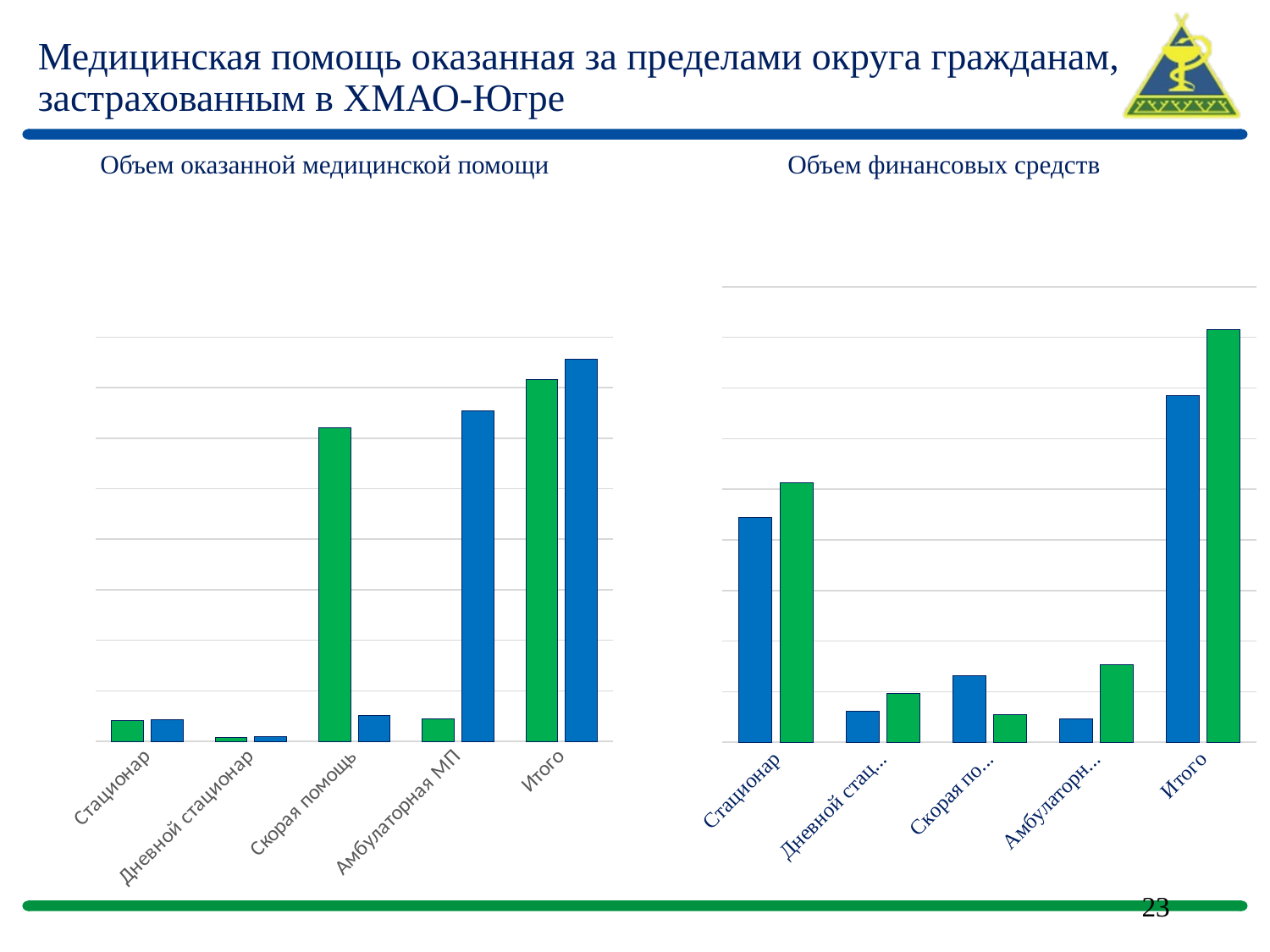
How many categories are shown on the x axis of the right chart "Объем финансовых средств"? 5 In the left chart "Объем оказанной медицинской помощи", for Скорая помощь, is the green bar or the blue bar taller? green In the right chart "Объем финансовых средств", for Стационар, is the green bar or the blue bar taller? green How many categories are shown on the x axis of the left chart "Объем оказанной медицинской помощи"? 5 In the left chart "Объем оказанной медицинской помощи", how many bars are shown for each category? 2 In the left chart "Объем оказанной медицинской помощи", which category has the tallest bar? Итого What is the title of the chart on the right side of the slide? Объем финансовых средств In the right chart "Объем финансовых средств", which category has the tallest bar? Итого In the left chart "Объем оказанной медицинской помощи", for Амбулаторная МП, is the green bar or the blue bar taller? blue What kind of chart is the right chart titled "Объем финансовых средств"? bar chart What kind of chart is the left chart titled "Объем оказанной медицинской помощи"? bar chart In the left chart "Объем оказанной медицинской помощи", which category has the shortest bars? Дневной стационар